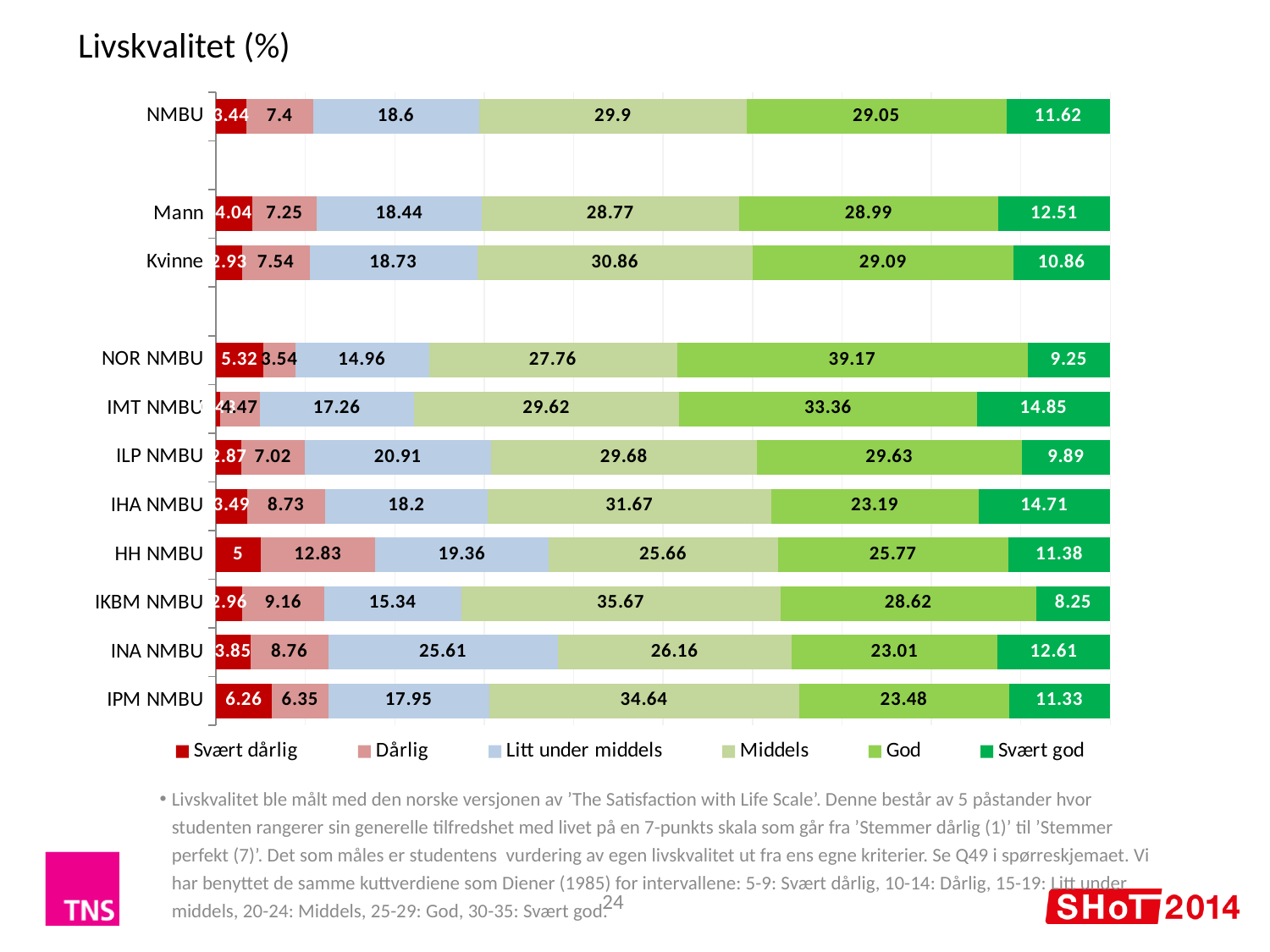
What kind of chart is shown on the slide? Stacked bar chart Which category has the highest God value? NOR NMBU What is the value of the Svært god segment for IMT NMBU? 14.85 What is the value of the Litt under middels segment for INA NMBU? 25.61 What is the value of the Middels segment for IKBM NMBU? 35.67 Which has the larger Middels value, Mann or Kvinne? Kvinne What is the difference between the Svært god values for Mann and Kvinne? 1.65 How many series does the legend list? 6 Which category has the lowest Svært god value? IKBM NMBU What is the value of the God segment for NOR NMBU? 39.17 Which category has the highest Dårlig value? HH NMBU How many categories are shown on the chart? 11